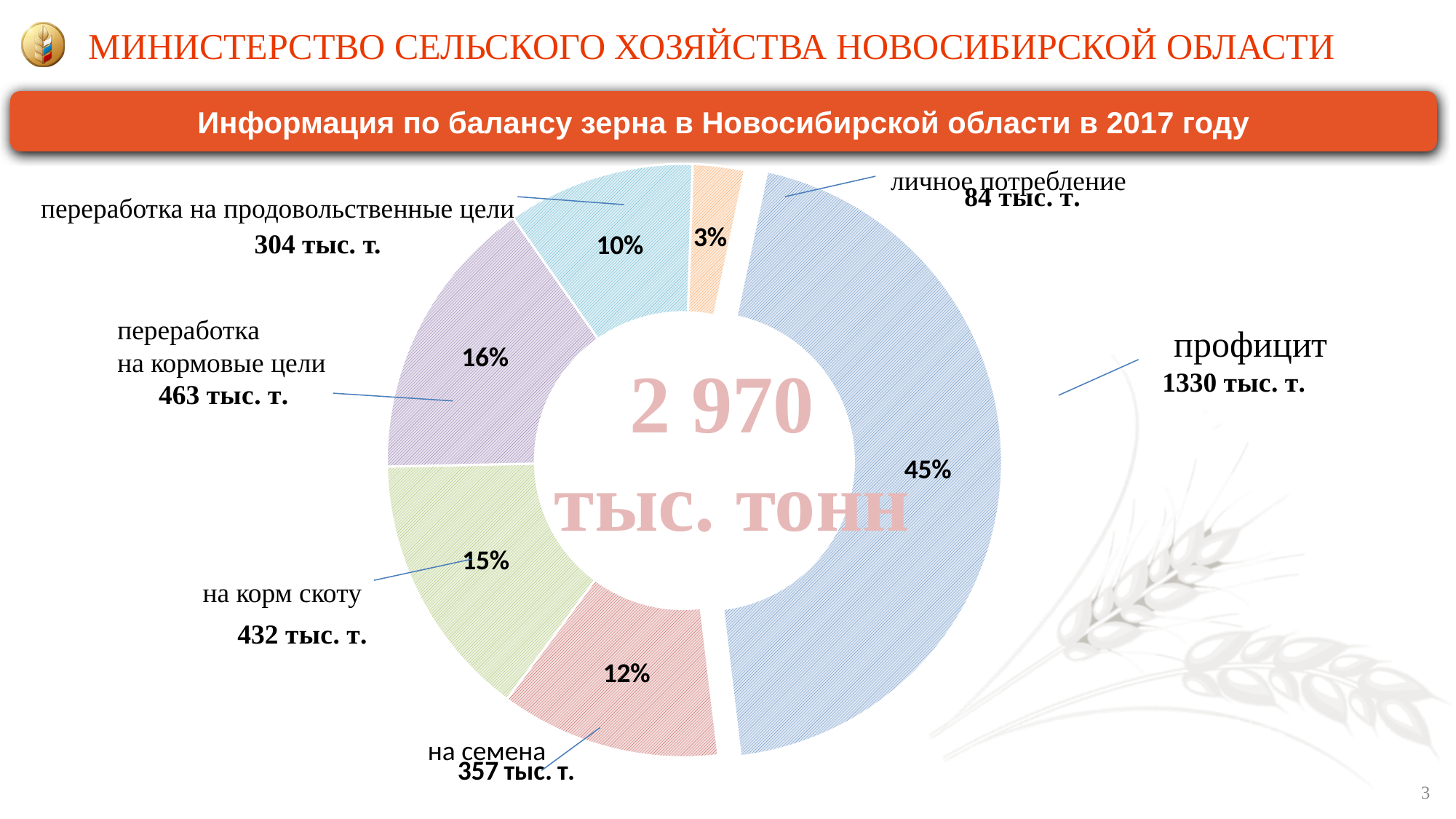
What percentage is shown for "личное потребление"? 3% What is the value shown for "переработка на кормовые цели"? 463 тыс. т. What share of the grain balance does "профицит" account for? 45% Which category has the smallest share of the chart? личное потребление What is the value shown for "на семена"? 357 тыс. т. What kind of chart is shown on the slide? doughnut chart Which is larger: "переработка на кормовые цели" or "переработка на продовольственные цели"? переработка на кормовые цели What total is printed in the centre of the chart? 2 970 тыс. тонн Which category has the largest share of the chart? профицит How many segments does the chart have? 6 What is the title of the slide's chart section? Информация по балансу зерна в Новосибирской области в 2017 году What is the difference in тыс. т. between "на корм скоту" and "на семена"? 75 тыс. т.